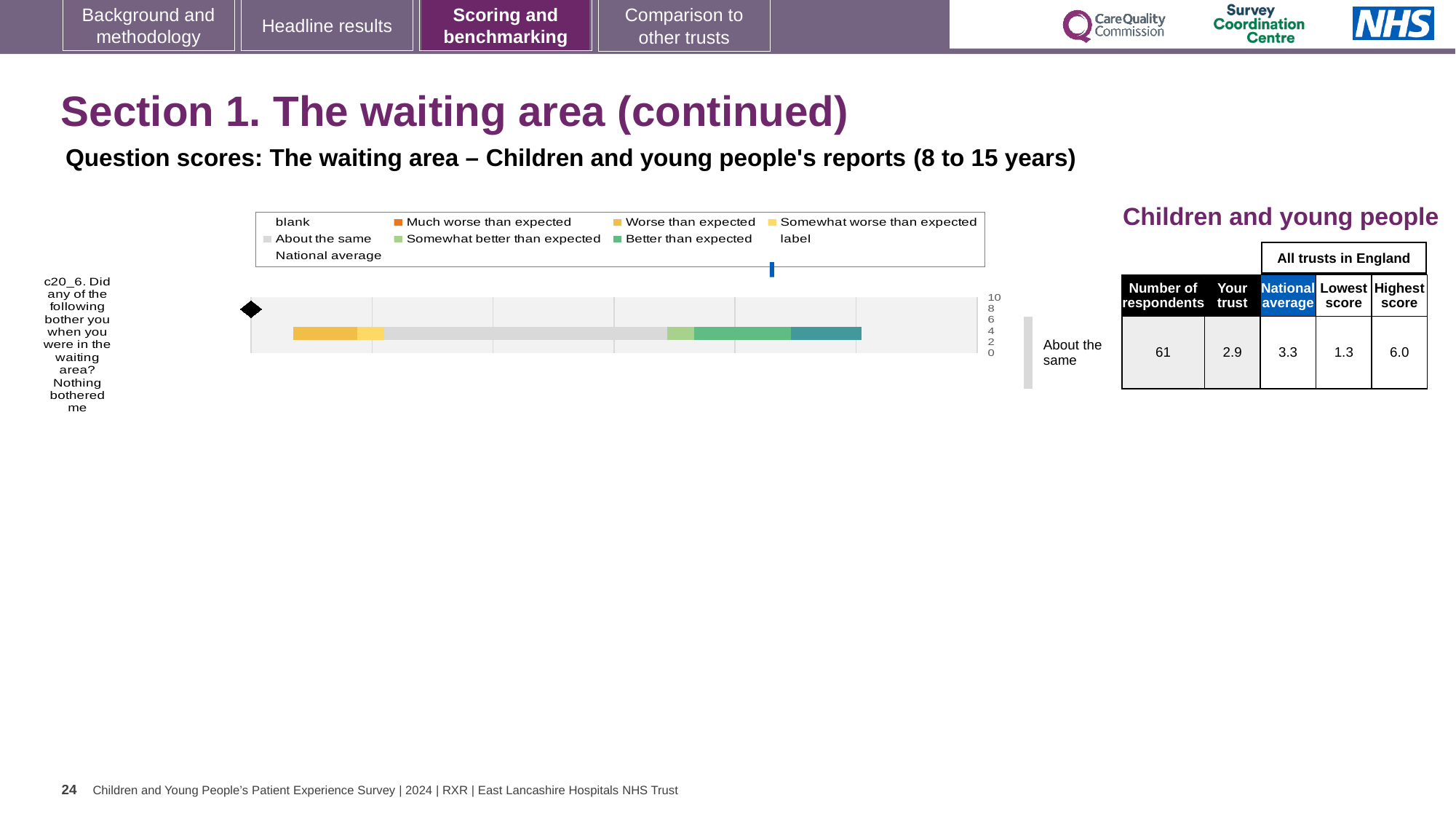
In the table next to the chart, what is the highest score across all trusts in England for question c20_6? 6.0 Is the 'Your trust' score for question c20_6 larger or smaller than the national average? smaller How many question categories are plotted in the bar chart? 1 What is the difference between the highest score and the lowest score for question c20_6 in the table? 4.7 In the table next to the chart, what is the national average score for question c20_6? 3.3 How many entries does the chart legend list? 9 Which legend entry is shown in orange? Much worse than expected What kind of chart is shown on the slide? bar chart In the table next to the chart, what is the lowest score across all trusts in England for question c20_6? 1.3 What benchmark label is shown to the right of the bar for question c20_6? About the same In the table next to the chart, what is the 'Your trust' score for question c20_6? 2.9 In the table next to the chart, what is the number of respondents for question c20_6? 61